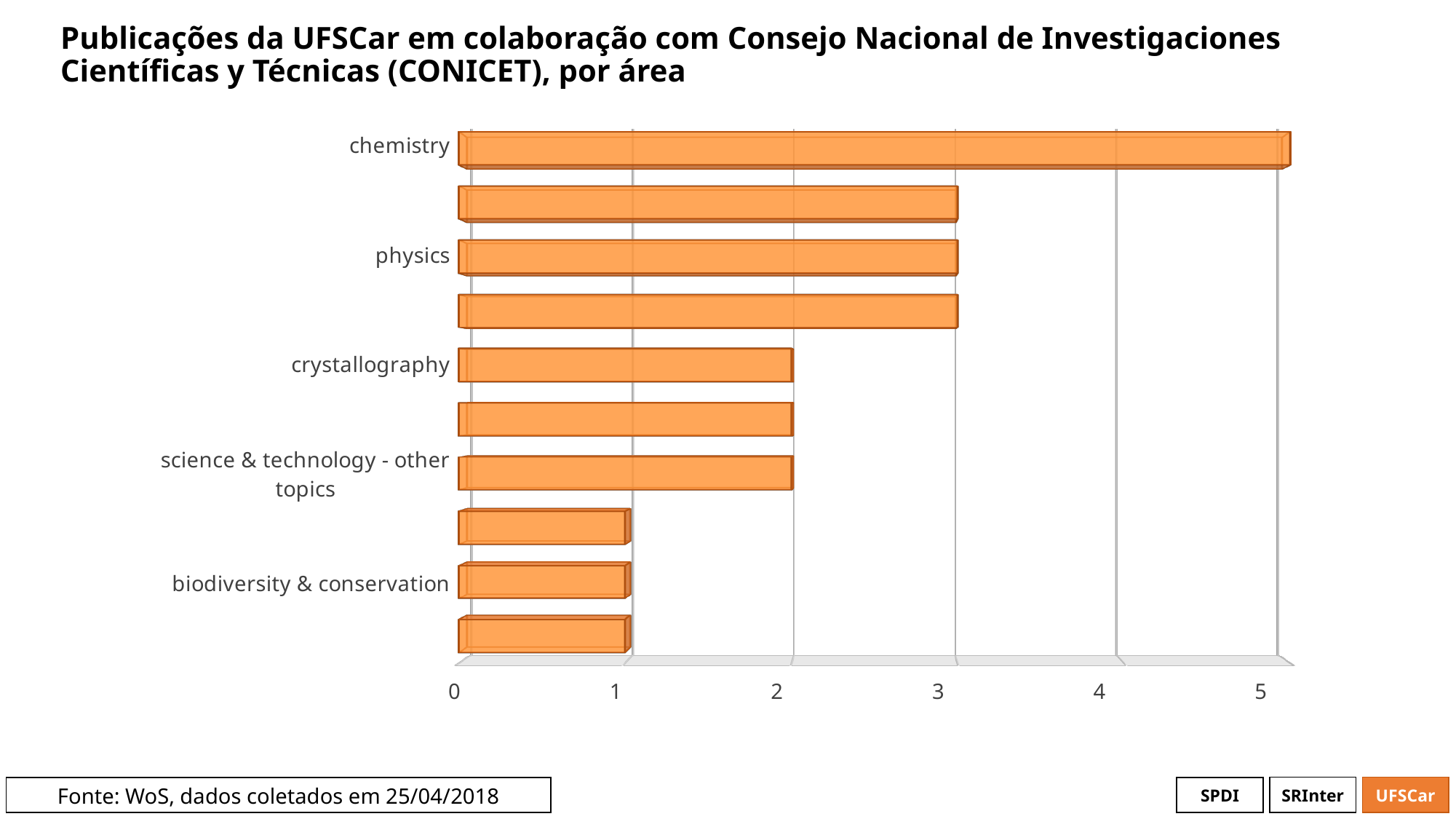
Is the value for chemistry greater or less than 4? greater Which labelled area has the highest value? chemistry Which labelled area has the lowest value? biodiversity & conservation What is the value for chemistry? 5 Which is larger, the value for physics or the value for crystallography? physics What kind of chart is shown on the slide? bar chart What is the value for crystallography? 2 What is the difference between the values for chemistry and physics? 2 What is the value for biodiversity & conservation? 1 How many bars are plotted in the chart? 10 What is the source cited at the bottom of the slide? WoS, dados coletados em 25/04/2018 What is the value for physics? 3